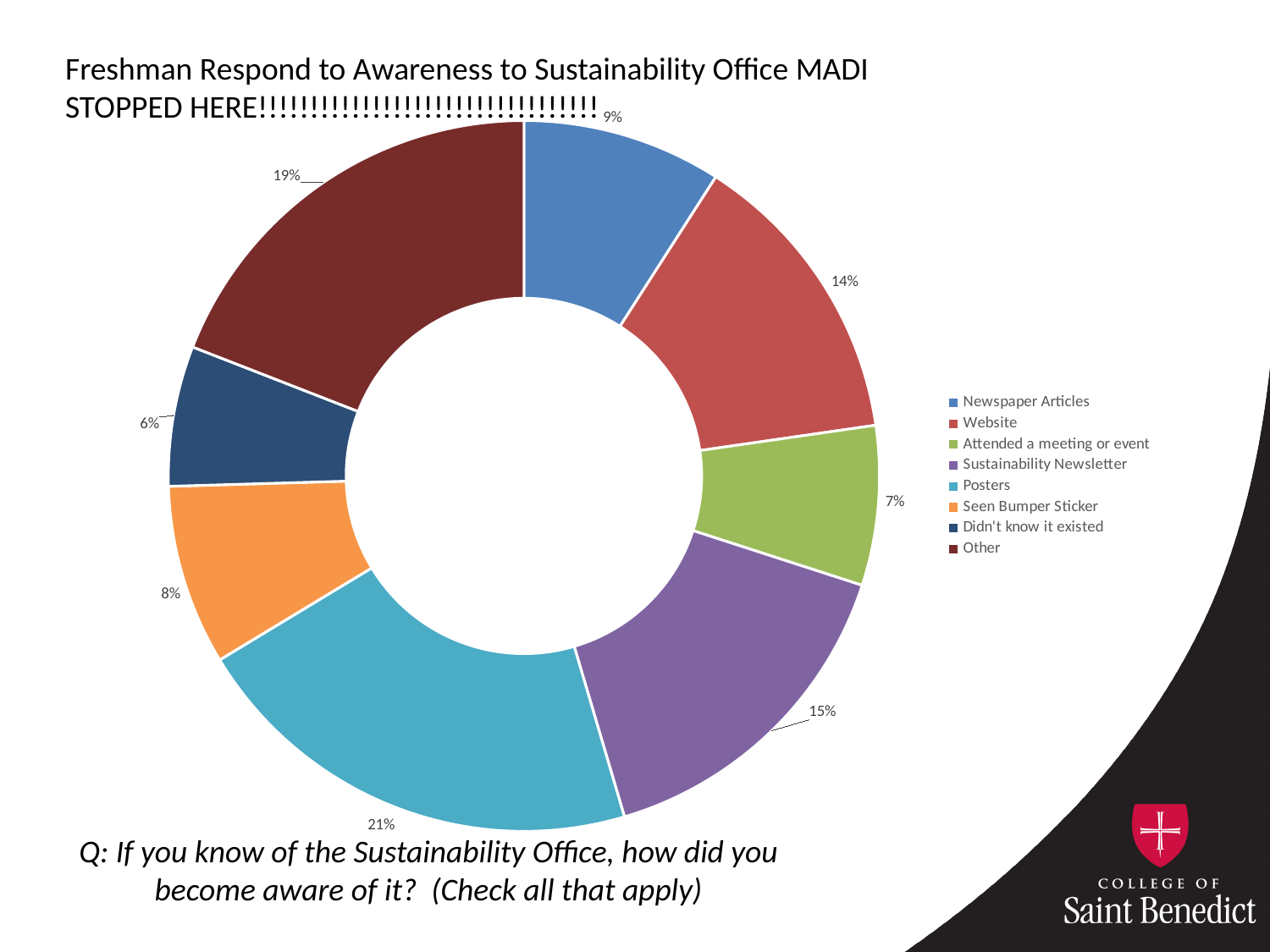
What percentage of responses is for Website? 14% Which category has the largest share of the chart? Posters What kind of chart is shown on the slide? Doughnut chart What percentage of responses is for Sustainability Newsletter? 15% What colour is the Posters segment in the chart? Light blue What percentage of responses is for Posters? 21% How many categories does the legend list? 8 What is the difference in percentage points between Other and Newspaper Articles? 10 What is the combined share of Posters and Other? 40% What percentage of responses is for Didn't know it existed? 6% Which is larger, the share for Seen Bumper Sticker or the share for Attended a meeting or event? Seen Bumper Sticker Which category has the smallest share of the chart? Didn't know it existed